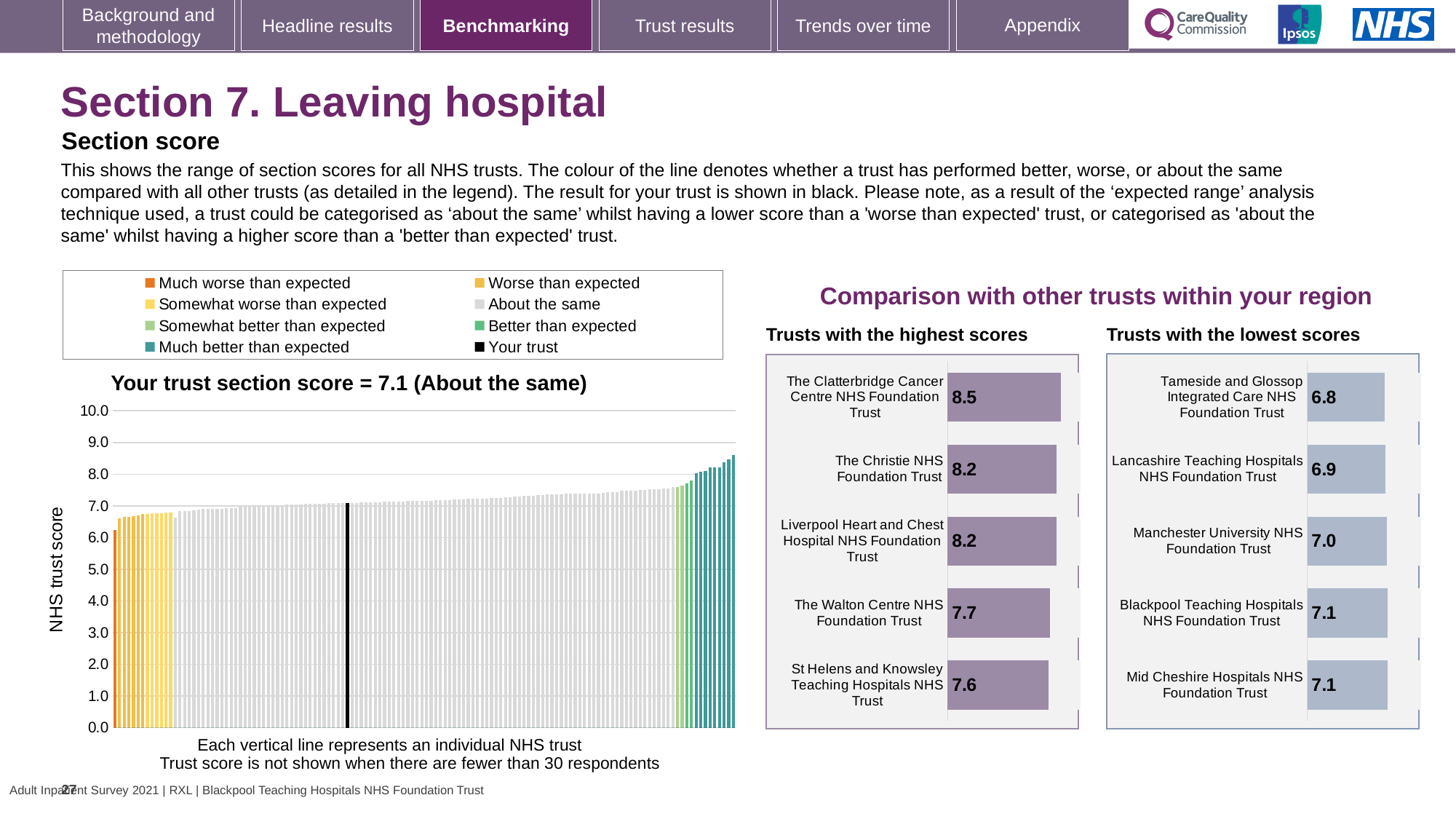
What kind of chart is the main section score chart on the left of the slide? Bar chart In the main section score chart on the left, what is the section score for your trust? 7.1 In the 'Trusts with the lowest scores' chart, which trust has the lowest score? Tameside and Glossop Integrated Care NHS Foundation Trust How many trusts are shown in the 'Trusts with the highest scores' chart? 5 In the 'Trusts with the lowest scores' chart, what is the difference between the scores of Blackpool Teaching Hospitals NHS Foundation Trust and Tameside and Glossop Integrated Care NHS Foundation Trust? 0.3 In the 'Trusts with the lowest scores' chart, what is the score for Tameside and Glossop Integrated Care NHS Foundation Trust? 6.8 In the 'Trusts with the highest scores' chart, what is the score for The Clatterbridge Cancer Centre NHS Foundation Trust? 8.5 In the 'Trusts with the highest scores' chart, what is the score for The Walton Centre NHS Foundation Trust? 7.7 In the 'Trusts with the highest scores' chart, which trust has the highest score? The Clatterbridge Cancer Centre NHS Foundation Trust In the 'Trusts with the lowest scores' chart, what is the score for Lancashire Teaching Hospitals NHS Foundation Trust? 6.9 Which has the higher score: The Walton Centre NHS Foundation Trust in the highest scores chart, or Manchester University NHS Foundation Trust in the lowest scores chart? The Walton Centre NHS Foundation Trust In the 'Trusts with the highest scores' chart, what is the difference between the scores of The Clatterbridge Cancer Centre NHS Foundation Trust and St Helens and Knowsley Teaching Hospitals NHS Trust? 0.9